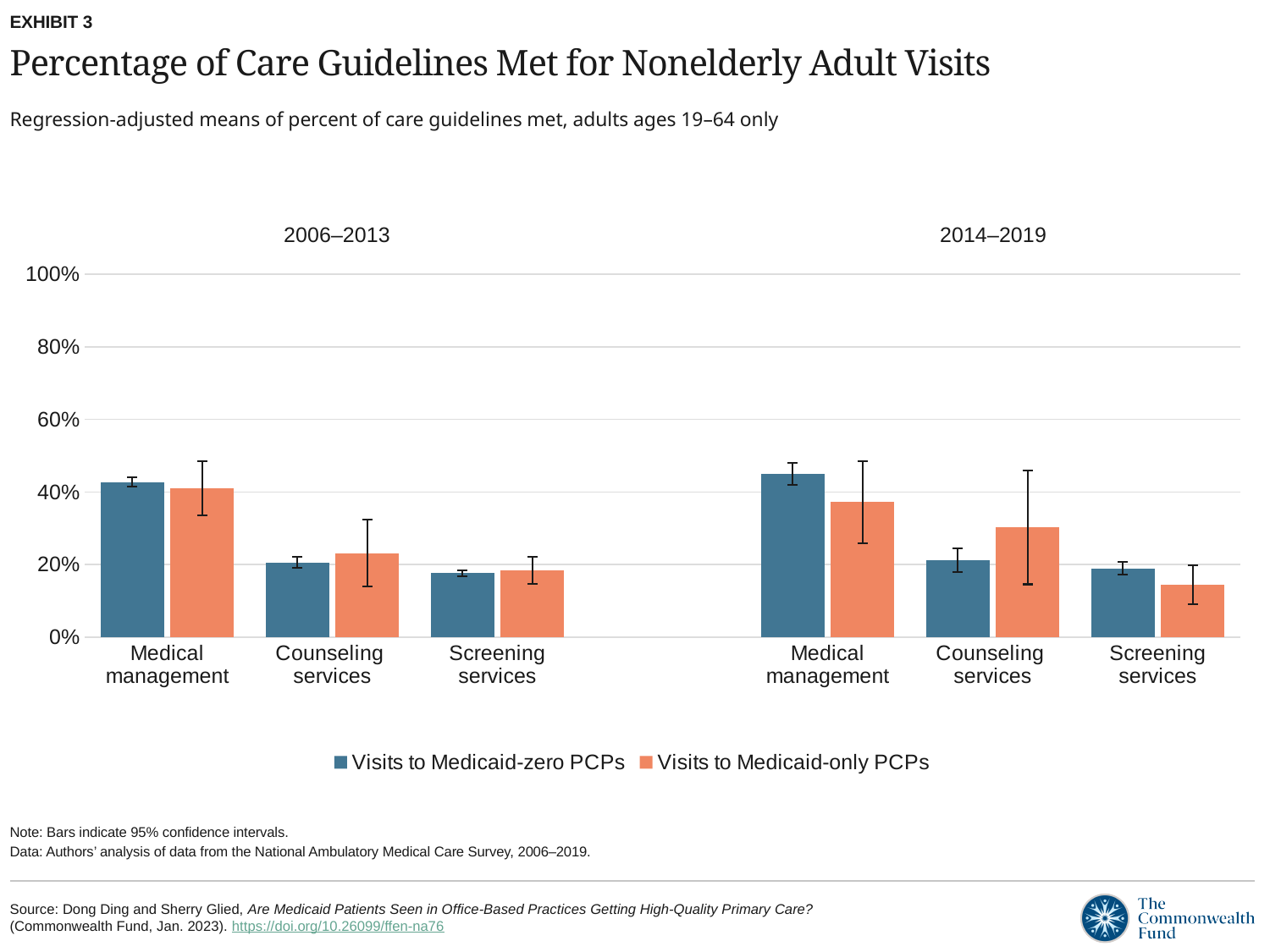
According to the note, what do the error bars on the chart indicate? 95% confidence intervals In the 2014–2019 panel, for Medical management, which series has the larger value? Visits to Medicaid-zero PCPs In the 2014–2019 panel, is the value for Counseling services for Visits to Medicaid-only PCPs greater or less than 20%? greater In the 2014–2019 panel, which bar is the lowest? Screening services, Visits to Medicaid-only PCPs How many categories are shown on the x axis of the 2006–2013 panel? 3 In the 2014–2019 panel, is the value for Medical management for Visits to Medicaid-only PCPs greater or less than 40%? less In the 2014–2019 panel, is the value for Screening services for Visits to Medicaid-only PCPs greater or less than 20%? less In the 2014–2019 panel, for Counseling services, which series has the larger value? Visits to Medicaid-only PCPs In the 2006–2013 panel, which category has the highest values for both series? Medical management What kind of chart is shown on the slide? bar chart How many series does the legend list? 2